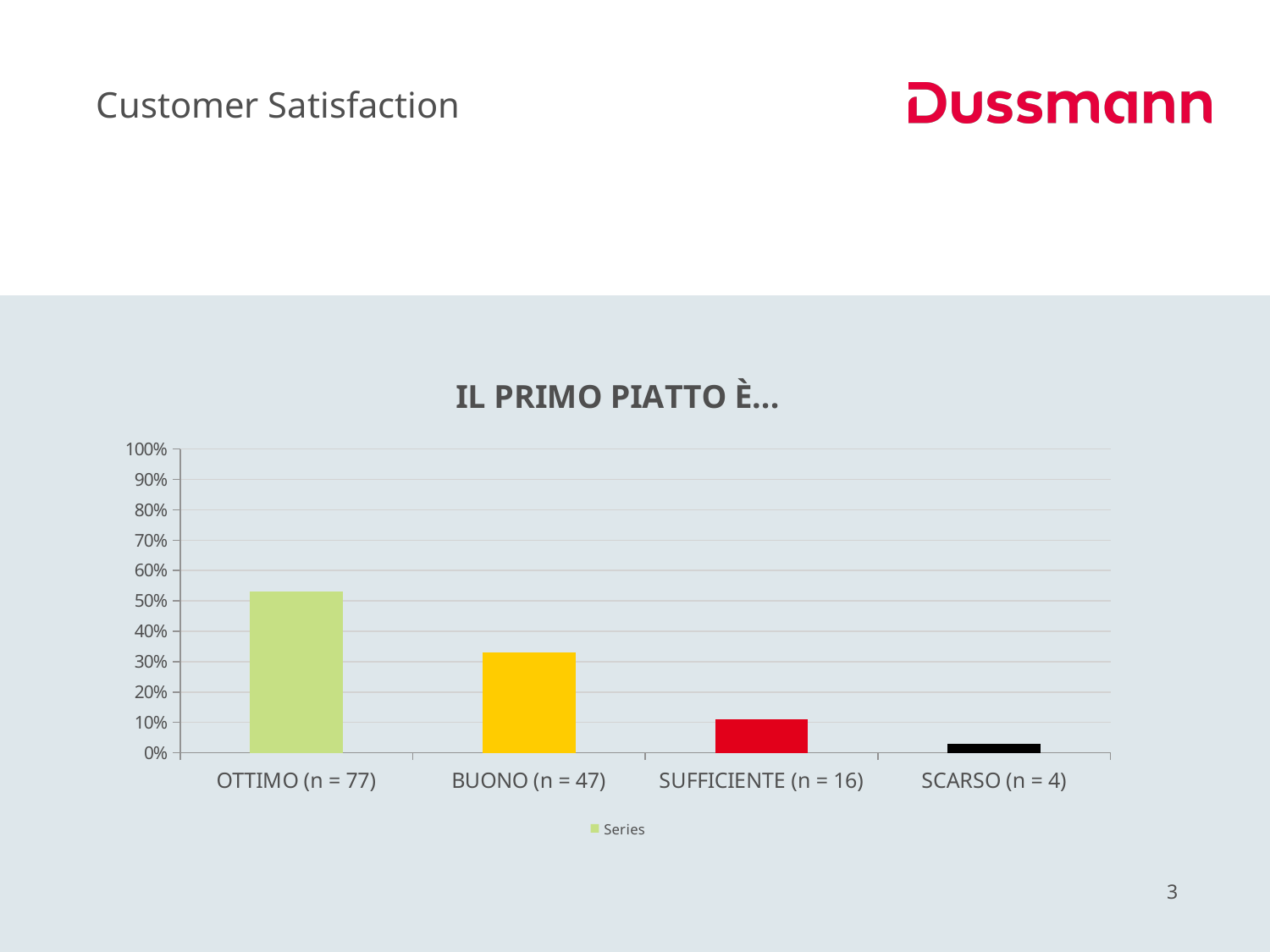
How many categories are shown on the x axis of the chart? 4 Is the value for SUFFICIENTE (n = 16) greater or less than 20%? less Do the bar values rise or fall from left to right along the x axis? fall What colour is the bar for OTTIMO (n = 77)? green How many series does the legend list? 1 Which is larger, the value for BUONO (n = 47) or the value for SUFFICIENTE (n = 16)? BUONO (n = 47) What is the title of the chart? IL PRIMO PIATTO È... What kind of chart is shown on the slide? bar chart Is the value for BUONO (n = 47) greater or less than 40%? less Which category has the highest bar? OTTIMO (n = 77) Which category has the lowest bar? SCARSO (n = 4) Is the value for OTTIMO (n = 77) greater or less than 40%? greater